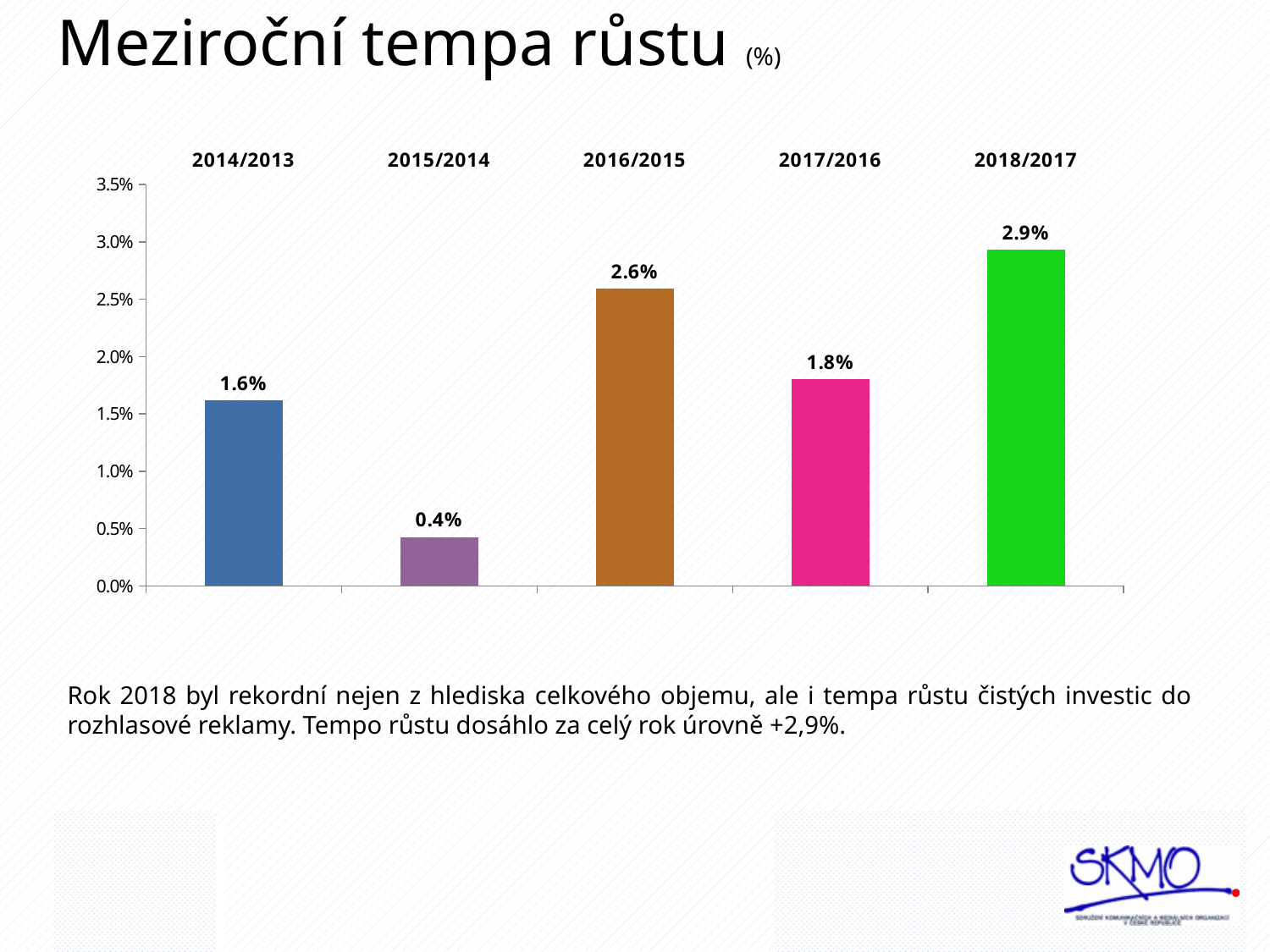
What is the difference between the values for 2018/2017 and 2017/2016? 1.1% Which is larger, the value for 2016/2015 or the value for 2017/2016? 2016/2015 Is the value for 2014/2013 greater or less than 2.0%? less What is the title of the chart on the slide? Meziroční tempa růstu (%) How many periods are shown on the chart? 5 What is the value shown for 2015/2014? 0.4% What is the year-on-year growth rate shown for 2016/2015? 2.6% Which period has the highest growth rate? 2018/2017 What is the difference between the values for 2014/2013 and 2015/2014? 1.2% What is the value shown for 2018/2017? 2.9% What kind of chart is shown on the slide? bar chart Which period has the lowest growth rate? 2015/2014